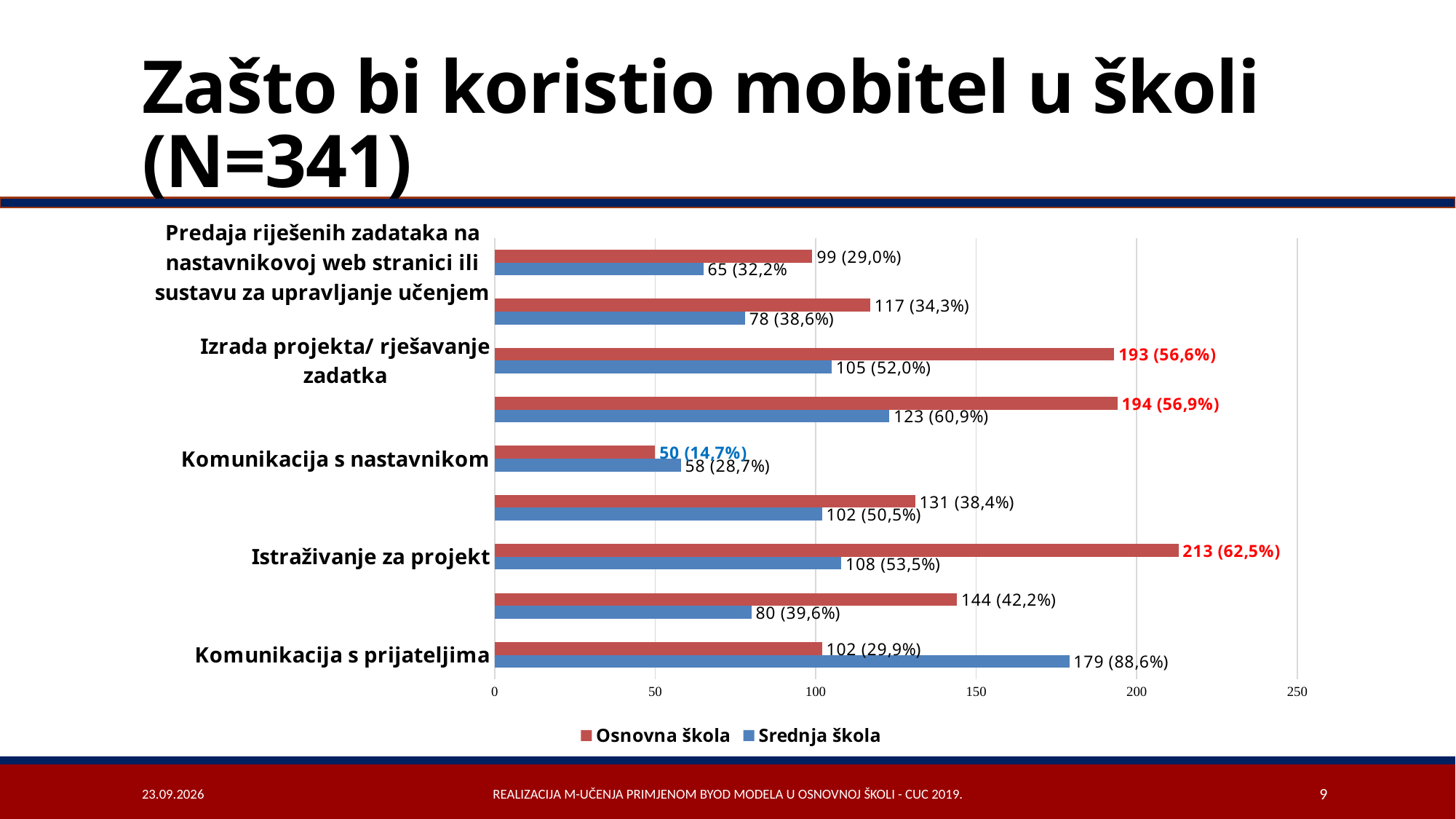
Which category has the lowest value for Osnovna škola? Komunikacija s nastavnikom In the category Istraživanje za projekt, what is the difference between the Osnovna škola count and the Srednja škola count? 105 In the category Komunikacija s prijateljima, which series has the larger value, Osnovna škola or Srednja škola? Srednja škola What is the value for Srednja škola in the category Izrada projekta/ rješavanje zadatka? 105 (52,0%) How many series does the legend list? 2 Which category has the highest value for Srednja škola? Komunikacija s prijateljima What is the value for Osnovna škola in the category Komunikacija s nastavnikom? 50 (14,7%) What is the value for Osnovna škola in the category Istraživanje za projekt? 213 (62,5%) What is the value for Osnovna škola in the category Predaja riješenih zadataka na nastavnikovoj web stranici ili sustavu za upravljanje učenjem? 99 (29,0%) Which category has the highest value for Osnovna škola? Istraživanje za projekt What is the value for Srednja škola in the category Komunikacija s prijateljima? 179 (88,6%) What kind of chart is shown on the slide? Bar chart